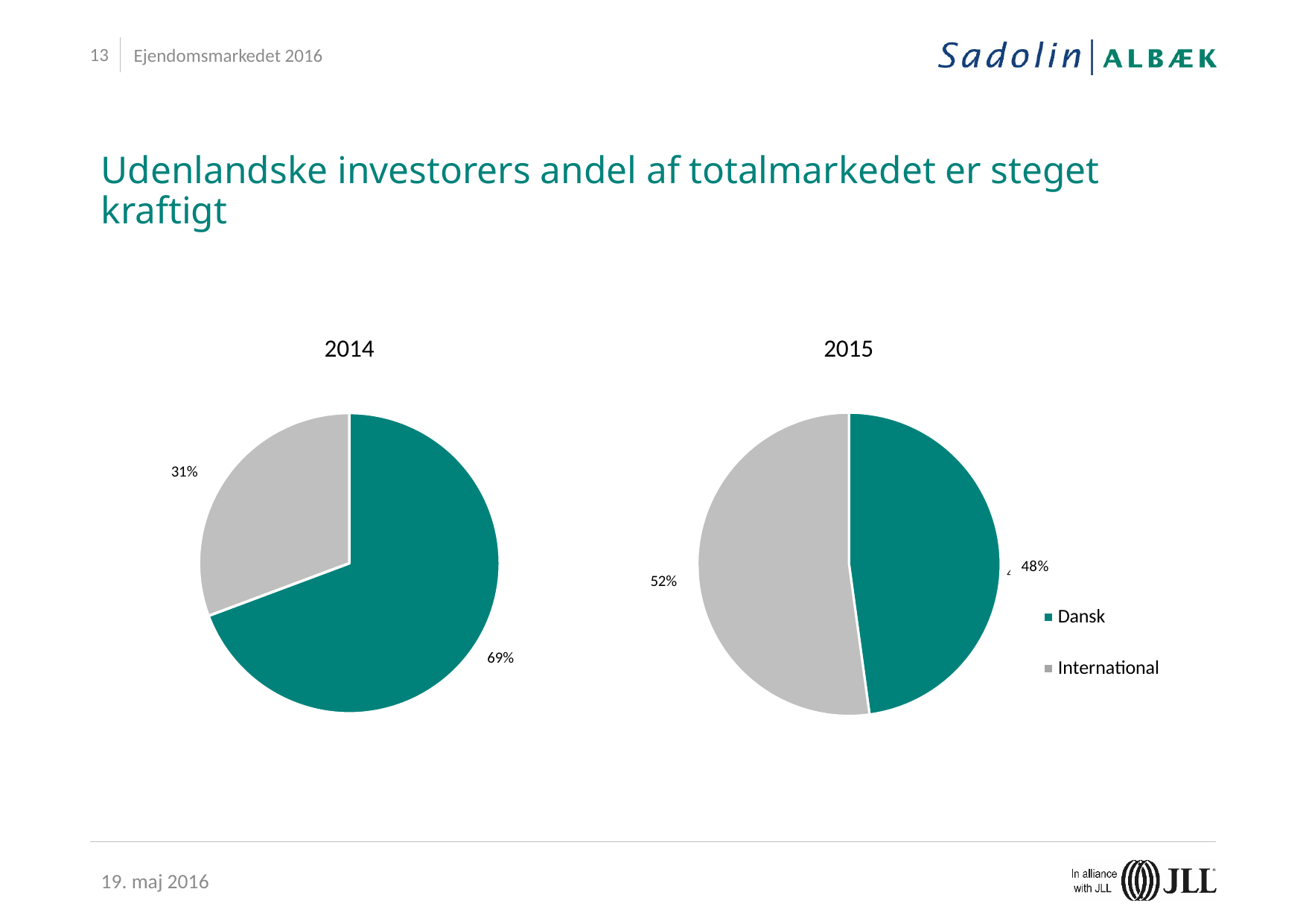
In the 2014 pie chart, what is the difference between the Dansk and International shares? 38% In the 2015 pie chart, which category has the smallest slice? Dansk How many slices does the 2015 pie chart have? 2 In the 2014 pie chart, what share does Dansk have? 69% How many entries does the legend list? 2 In the 2014 pie chart, which category has the largest slice? Dansk In the 2015 pie chart, is the International share larger or smaller than the Dansk share? larger What type of chart is used for 2014 and 2015 on this slide? pie chart Which colour represents International in the pie charts? grey In the 2015 pie chart, what share does International have? 52% In the 2015 pie chart, what share does Dansk have? 48% In the 2014 pie chart, what share does International have? 31%